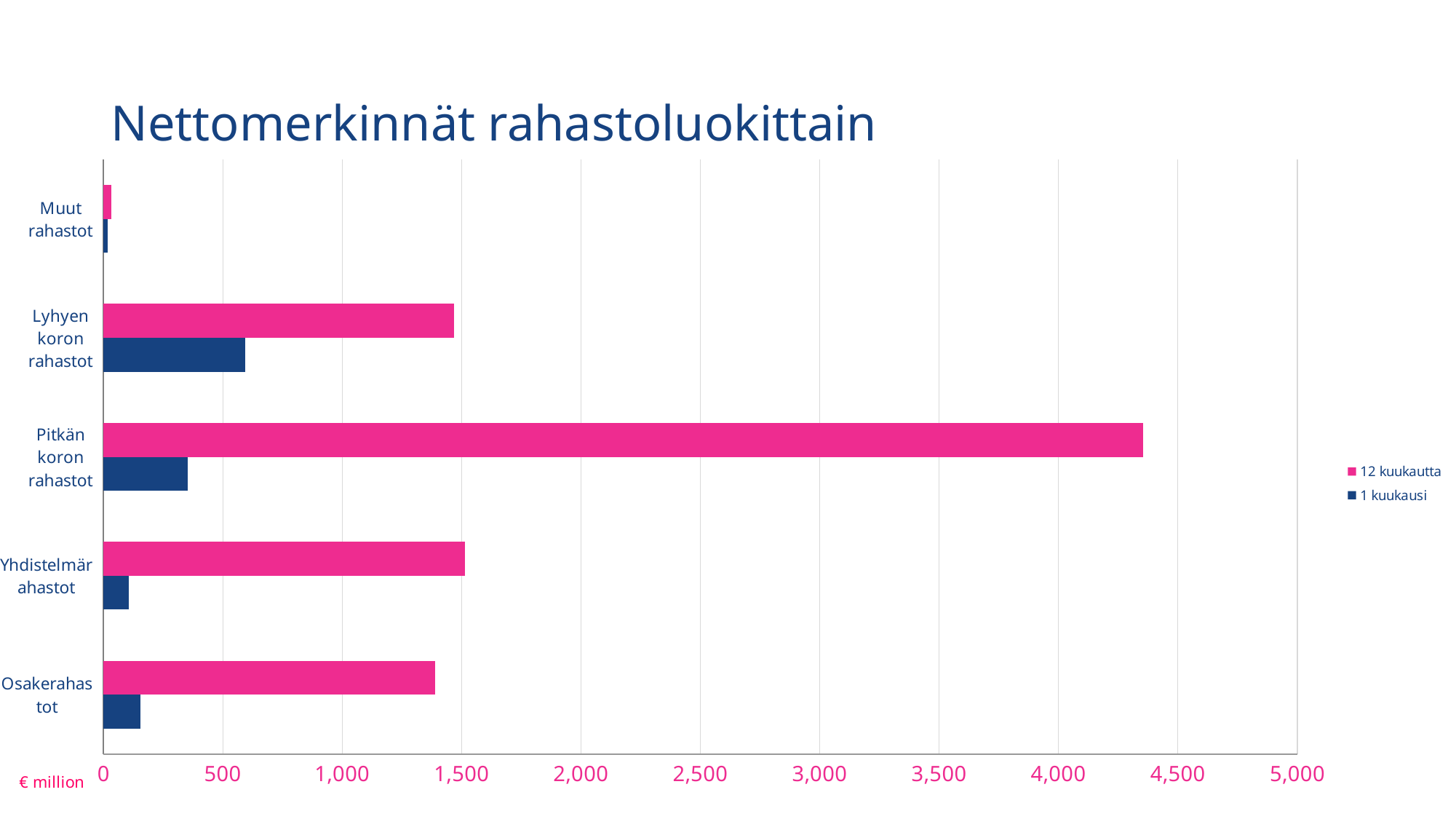
Which category has the highest value for the 12 kuukautta series? Pitkän koron rahastot How many fund categories are shown on the chart? 5 What kind of chart is shown on the slide? bar chart What is the title of the chart? Nettomerkinnät rahastoluokittain Is the 1 kuukausi value for Pitkän koron rahastot greater or less than 500? less Is the 1 kuukausi value for Lyhyen koron rahastot greater or less than 500? greater Is the 12 kuukautta value for Osakerahastot greater or less than 1,500? less For the 1 kuukausi series, which is larger: Lyhyen koron rahastot or Pitkän koron rahastot? Lyhyen koron rahastot How many series does the legend list? 2 Which category has the highest value for the 1 kuukausi series? Lyhyen koron rahastot Which category has the lowest value for the 12 kuukautta series? Muut rahastot